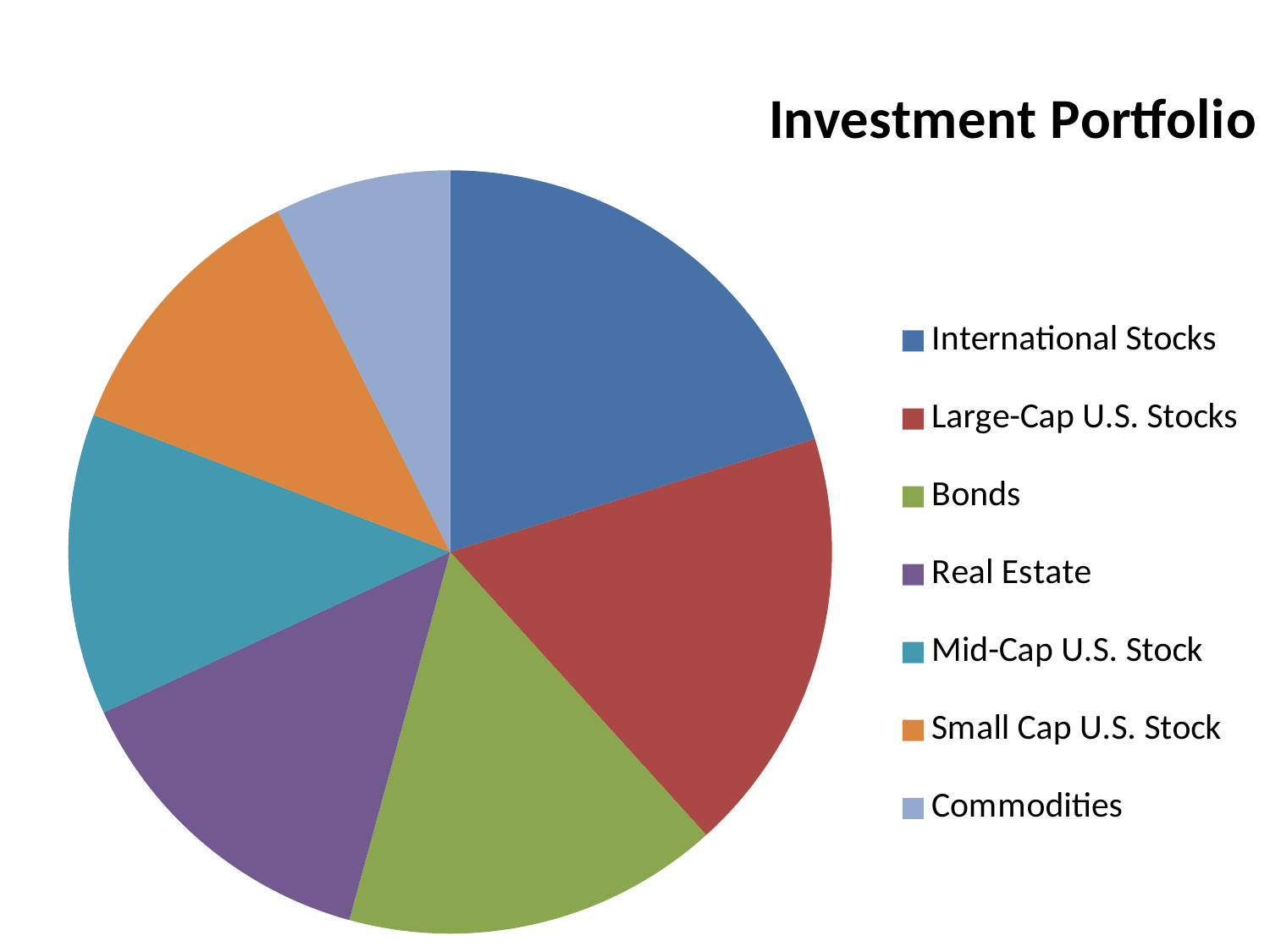
Which slice is larger, Large-Cap U.S. Stocks or Small Cap U.S. Stock? Large-Cap U.S. Stocks How many entries does the legend list? 7 Which slice is larger, International Stocks or Mid-Cap U.S. Stock? International Stocks Which slice is larger, Bonds or Commodities? Bonds Which category is shown in green in the pie chart? Bonds How many slices does the pie chart have? 7 Which category has the smallest slice of the pie? Commodities What is the title of the chart? Investment Portfolio What kind of chart is shown on the slide? Pie chart